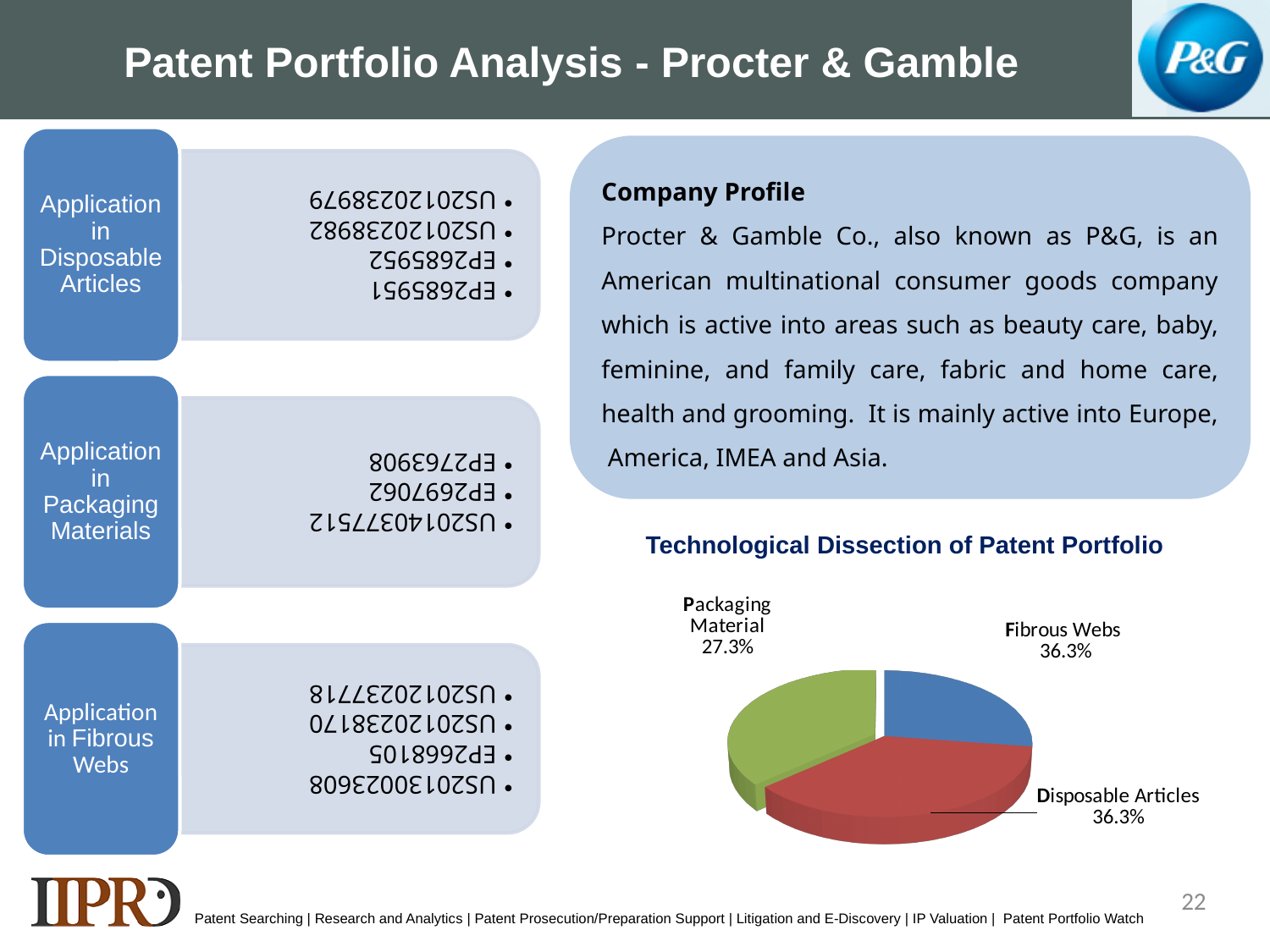
What share of the pie chart does Disposable Articles represent? 36.3% What is the difference in percentage points between the Fibrous Webs share and the Packaging Material share? 9.0% How many categories are shown in the pie chart? 3 Which is larger in the pie chart, Packaging Material or Fibrous Webs? Fibrous Webs Which category has the smallest share in the pie chart? Packaging Material What colour is the Disposable Articles slice in the pie chart? Red What share of the pie chart does Packaging Material represent? 27.3% Is the share for Packaging Material greater or less than 30%? less What is the title of the chart on the slide? Technological Dissection of Patent Portfolio What share of the pie chart does Fibrous Webs represent? 36.3% What type of chart is shown on the slide? Pie chart